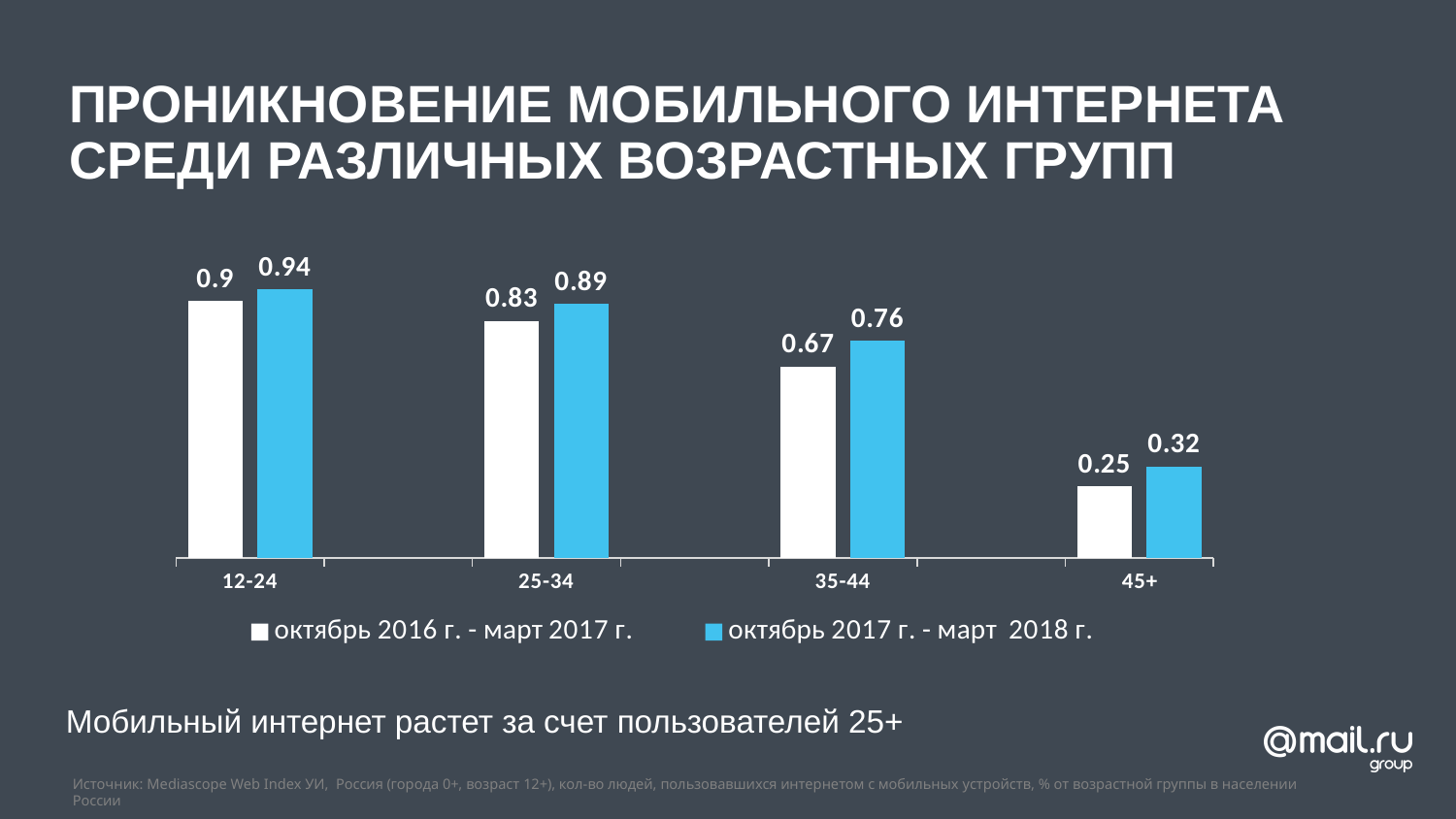
Which age group has the lowest value in the October 2017 – March 2018 series? 45+ What is the difference between the two series for the 45+ age group? 0.07 How many age groups are shown on the x axis? 4 How many series does the legend list? 2 Which is larger for the 25-34 age group: the October 2016 – March 2017 value or the October 2017 – March 2018 value? October 2017 – March 2018 What kind of chart is shown on the slide? Bar chart What is the value for the 12-24 age group in the October 2017 – March 2018 series? 0.94 What is the difference between the two series for the 35-44 age group? 0.09 What is the value for the 35-44 age group in the October 2017 – March 2018 series? 0.76 Which age group has the highest value in the October 2016 – March 2017 series? 12-24 What is the value for the 45+ age group in the October 2016 – March 2017 series? 0.25 Do the values in the October 2017 – March 2018 series rise or fall as the age groups move from 12-24 to 45+? Fall